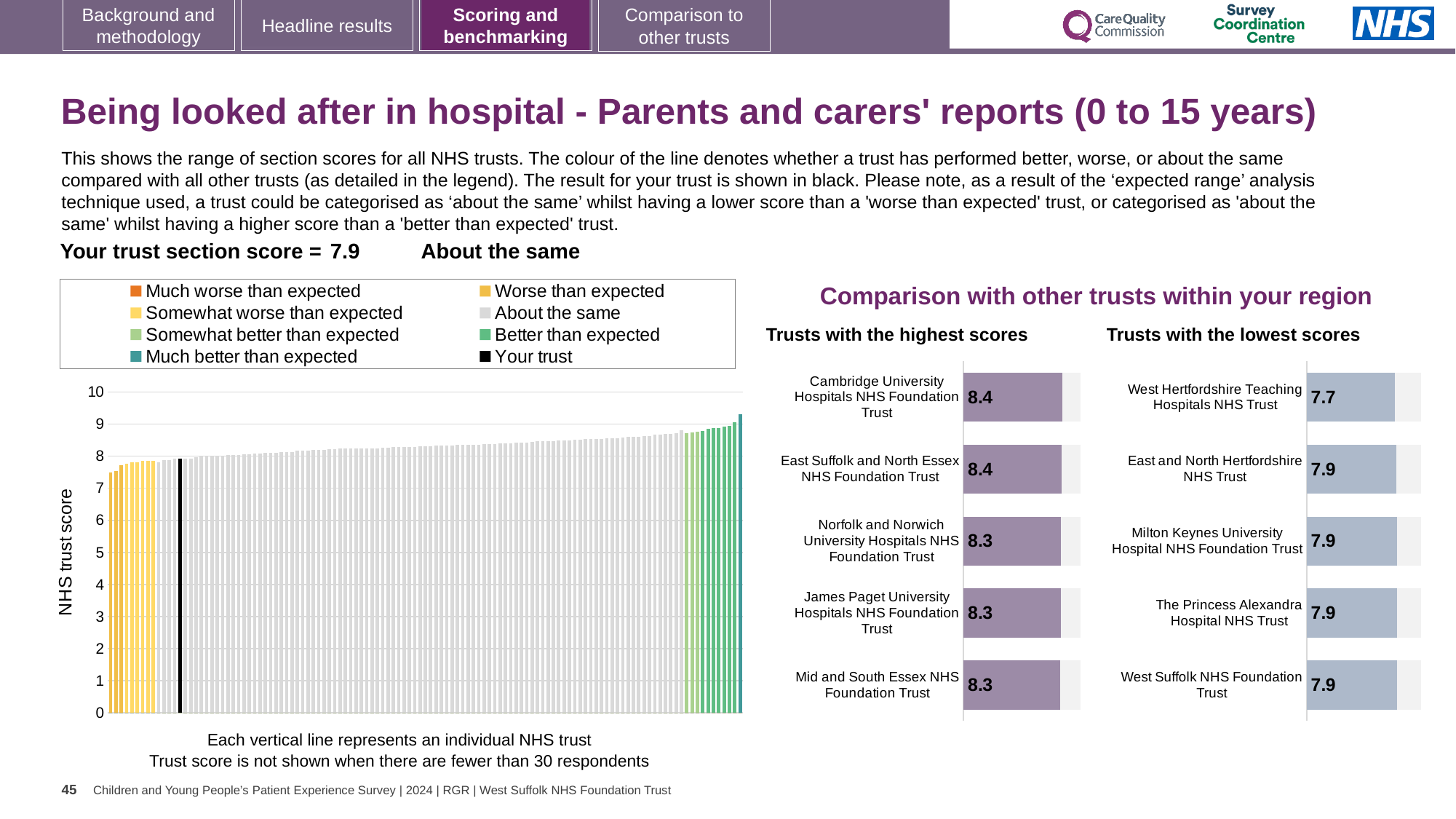
In the 'Trusts with the lowest scores' chart, what is the score for West Suffolk NHS Foundation Trust? 7.9 What kind of chart is the large 'NHS trust score' chart on the left? Bar chart How many trusts are shown in the 'Trusts with the lowest scores' chart? 5 In the large 'NHS trust score' chart, is the value of the tallest bar on the far right greater or less than 9? greater What is the difference between the score for Cambridge University Hospitals NHS Foundation Trust in the 'highest scores' chart and West Hertfordshire Teaching Hospitals NHS Trust in the 'lowest scores' chart? 0.7 In the 'Trusts with the highest scores' chart, what is the score for Cambridge University Hospitals NHS Foundation Trust? 8.4 How many entries does the legend of the large 'NHS trust score' chart list? 8 In the 'Trusts with the highest scores' chart, what is the score for Mid and South Essex NHS Foundation Trust? 8.3 In the 'Trusts with the highest scores' chart, which is larger: the score for Cambridge University Hospitals NHS Foundation Trust or Norfolk and Norwich University Hospitals NHS Foundation Trust? Cambridge University Hospitals NHS Foundation Trust In the large 'NHS trust score' chart, do the values rise or fall from left to right? Rise In the 'Trusts with the lowest scores' chart, what is the score for West Hertfordshire Teaching Hospitals NHS Trust? 7.7 In the 'Trusts with the lowest scores' chart, which trust has the lowest score? West Hertfordshire Teaching Hospitals NHS Trust